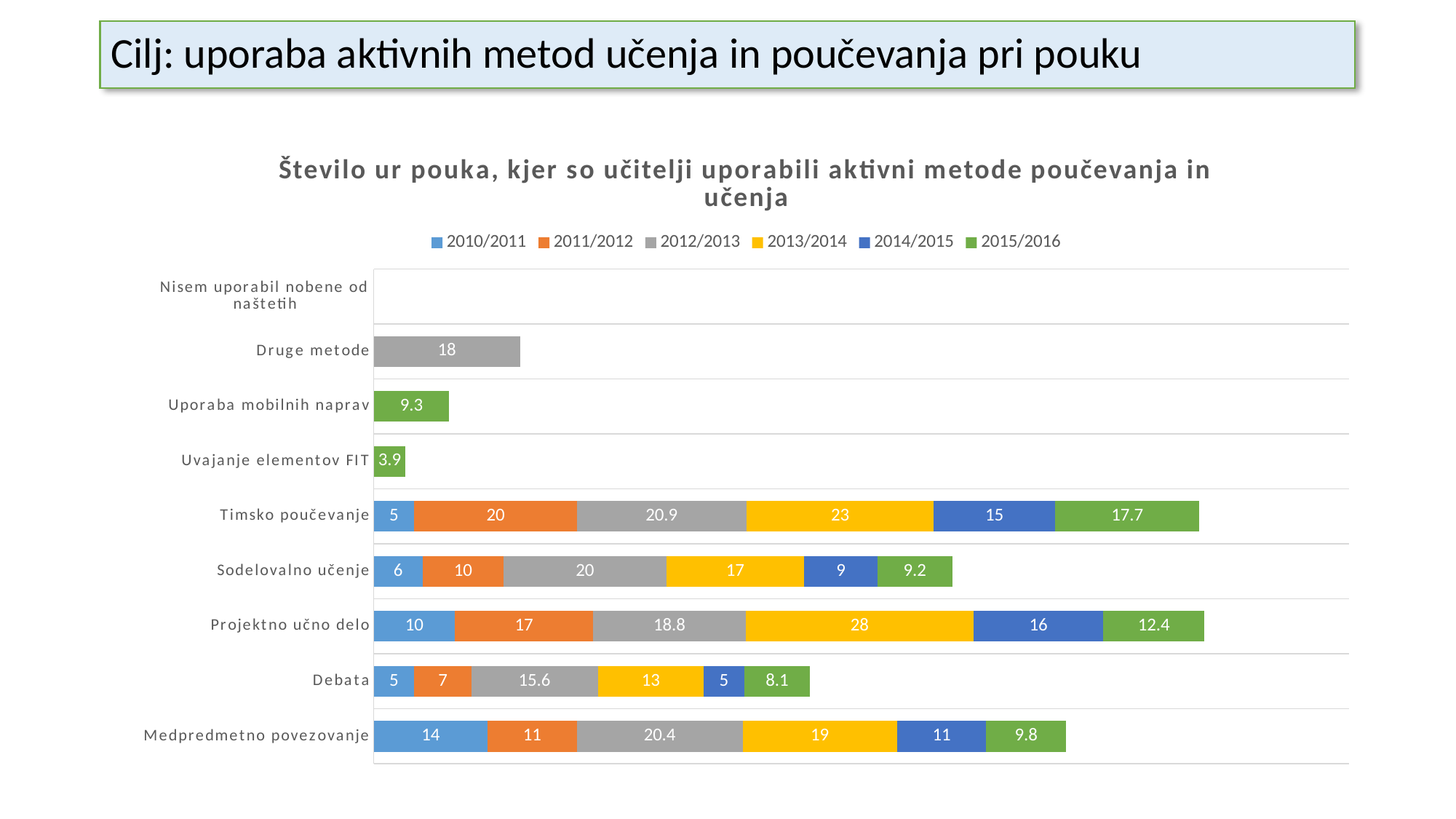
What kind of chart is shown on the slide? stacked bar chart What is the value for Druge metode in 2012/2013? 18 What is the value for Projektno učno delo in 2013/2014? 28 What is the total of the stacked bar for Debata? 53.7 Which category has the highest value in the 2010/2011 series? Medpredmetno povezovanje Which is larger: the 2011/2012 value for Timsko poučevanje or for Sodelovalno učenje? Timsko poučevanje What is the value for Timsko poučevanje in 2012/2013? 20.9 How many series does the legend list? 6 What is the value for Uporaba mobilnih naprav in 2015/2016? 9.3 Which category has the highest value in the 2013/2014 series? Projektno učno delo How many categories are listed on the vertical axis? 9 What is the difference between the 2013/2014 values for Projektno učno delo and Debata? 15